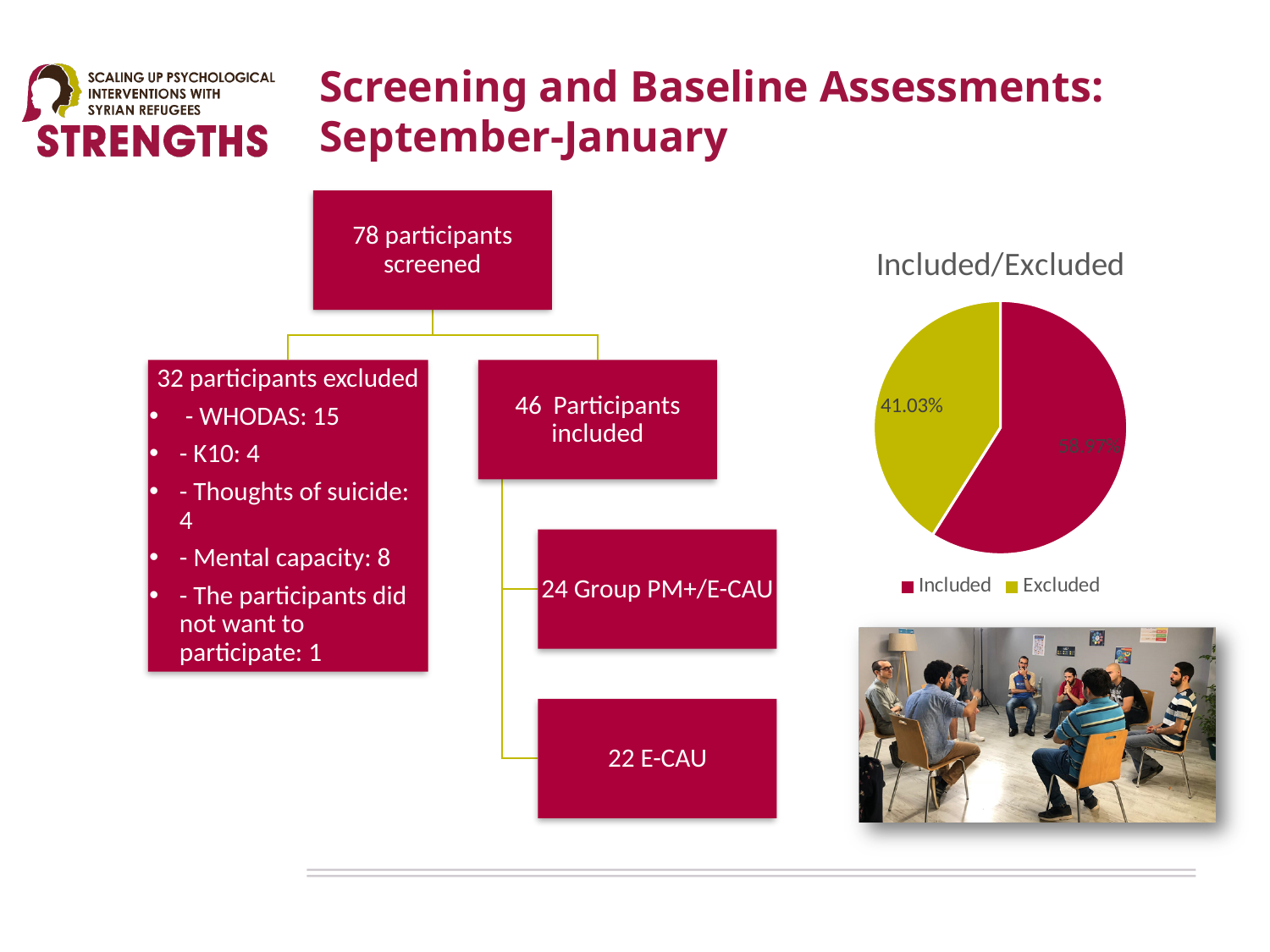
How many slices does the pie chart have? 2 What percentage of the pie chart is labelled for the Excluded slice? 41.03% Is the share of the Included slice greater or less than 50%? greater Which category has the largest share of the pie chart? Included Which slice of the pie chart is larger, Included or Excluded? Included How many entries does the legend of the pie chart list? 2 What colour represents the Excluded slice in the pie chart? yellow-green What is the title of the pie chart? Included/Excluded Is the share of the Excluded slice greater or less than 50%? less What kind of chart is shown on the slide? pie chart Which category has the smallest share of the pie chart? Excluded